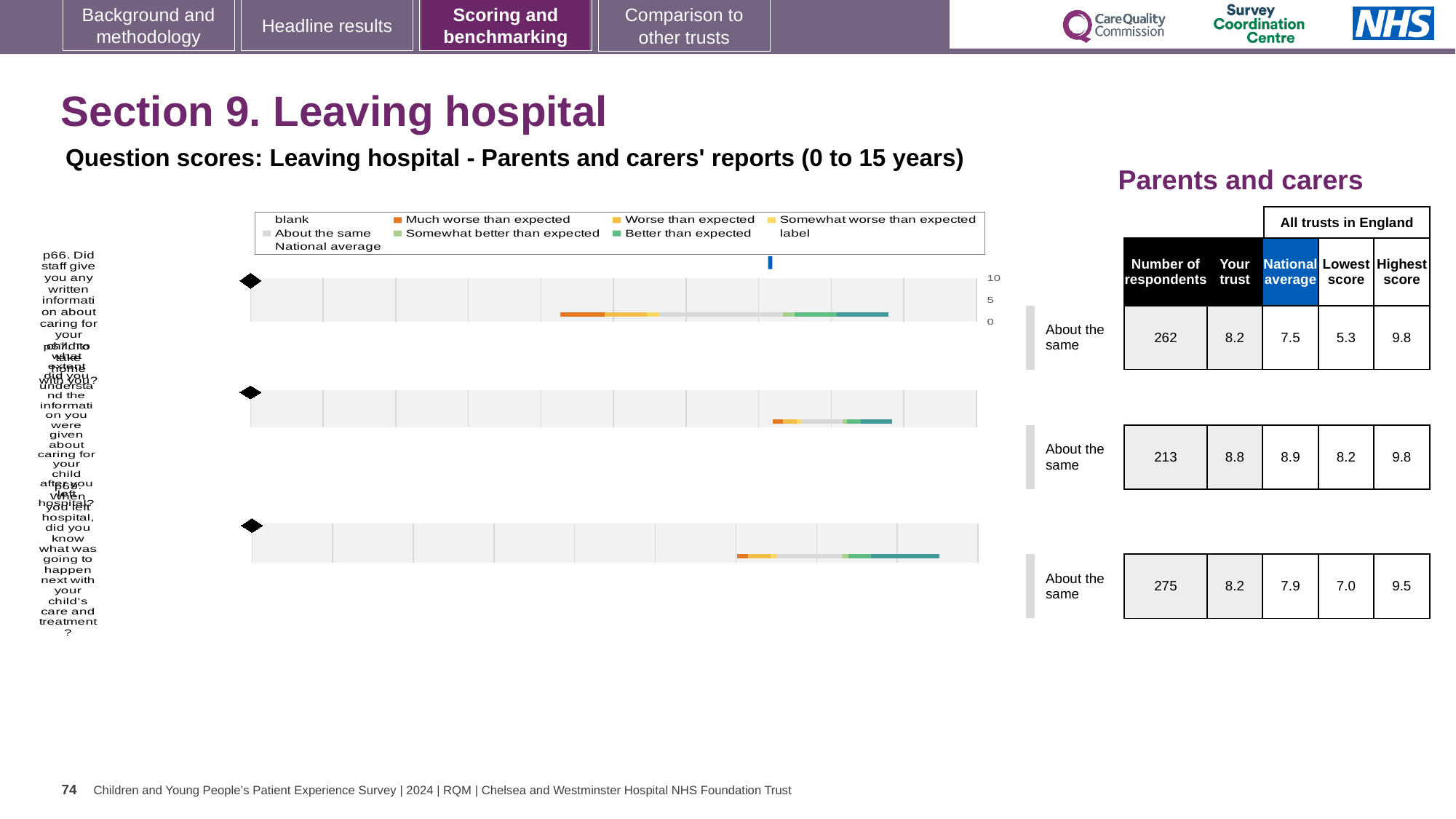
In the table beside the charts, what is the highest score for the third row (275 respondents)? 9.5 In the table beside the charts, what is the national average for the second row (213 respondents)? 8.9 Which legend entry is shown in orange? Much worse than expected In the table beside the charts, what is the 'Your trust' score for the first row (262 respondents)? 8.2 In the table beside the charts, which row has the highest 'Your trust' score? the second row (213 respondents), 8.8 In the table beside the charts, what is the difference between the 'Your trust' score and the national average in the first row (262 respondents)? 0.7 How many entries does the chart legend list? 9 What kind of chart is used to show the question scores on this slide? bar chart What is the highest tick value shown on the axis of the top chart? 10 In the table beside the charts, is the 'Your trust' score or the national average larger in the second row (213 respondents)? national average In the table beside the charts, what is the lowest score for the first row (262 respondents)? 5.3 How many separate bar charts are shown on the slide? 3